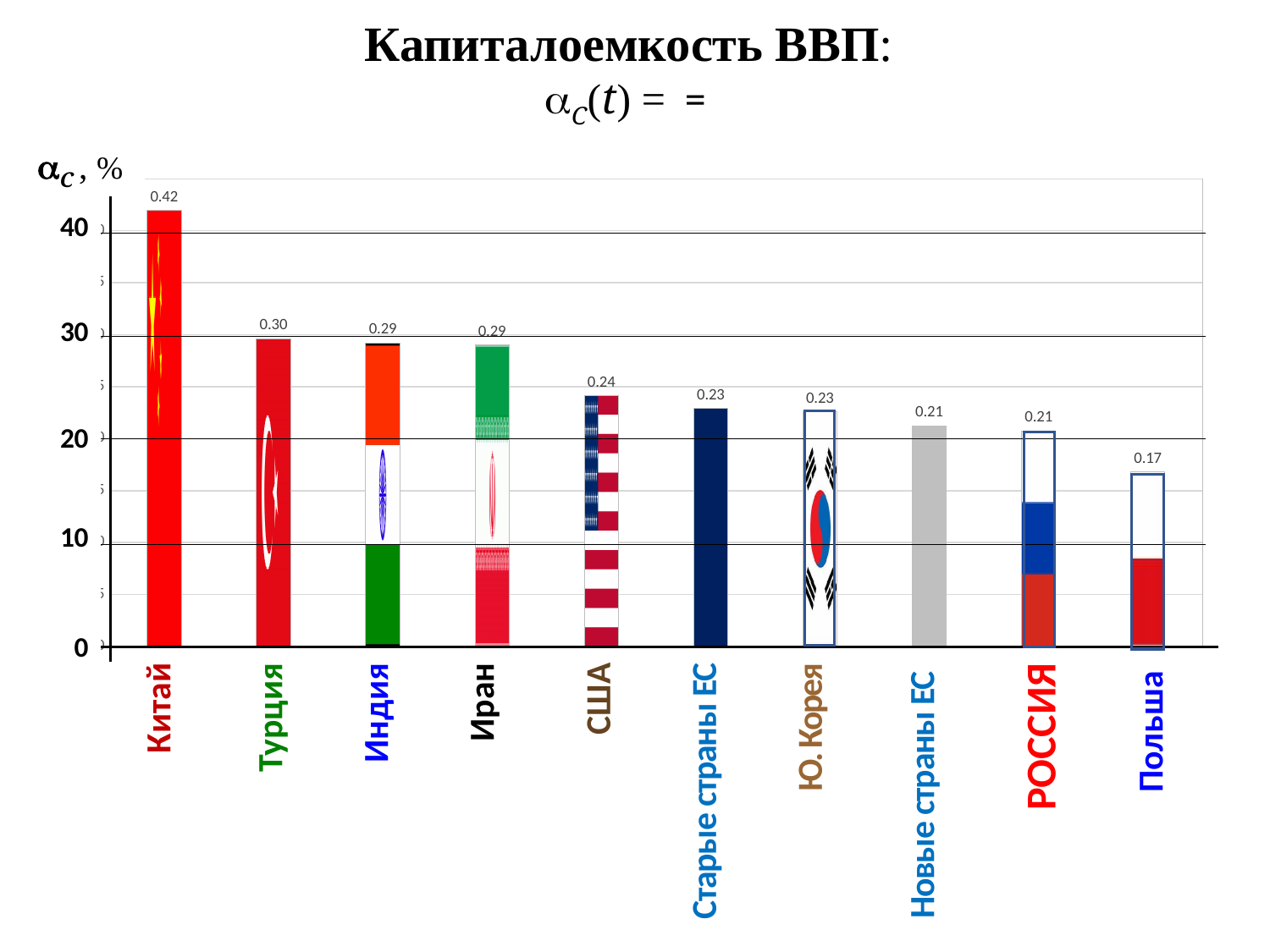
What is the data label shown for Китай? 0.42 What is the data label shown for США? 0.24 What is the data label shown for Польша? 0.17 Is the value for Новые страны ЕС greater or less than 30 on the axis? less What kind of chart is shown on the slide? bar chart Which is larger, the value for Турция or the value for США? Турция Which category has the highest value? Китай What is the difference between the data labels for Китай and Польша? 0.25 What is the data label shown for Турция? 0.30 What is the data label shown for РОССИЯ? 0.21 Which category has the lowest value? Польша How many categories are shown on the x axis? 10